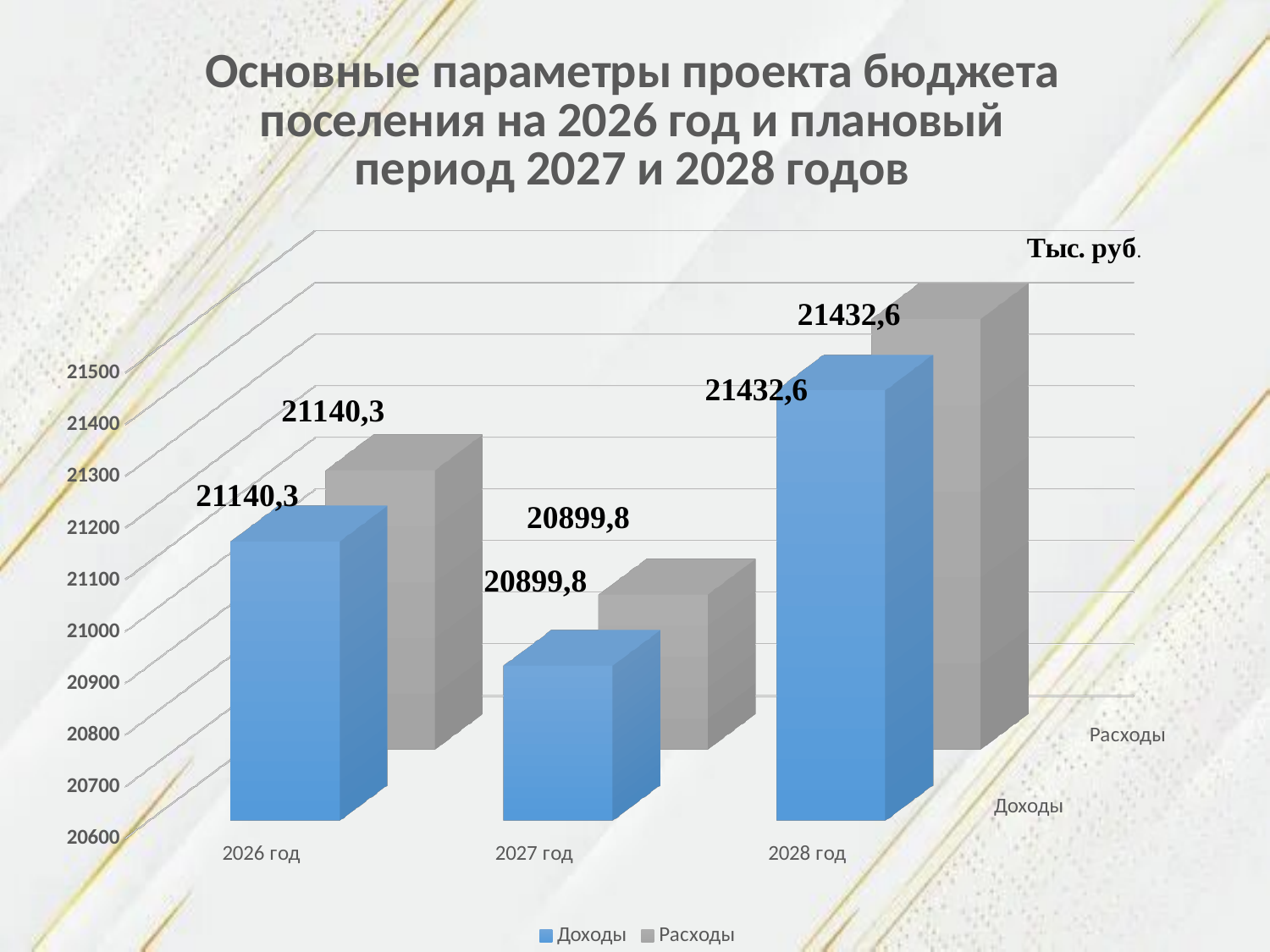
What kind of chart is shown on the slide? bar chart How many series does the legend list? 2 What is the value of Доходы for 2026 год? 21140,3 What is the value of Расходы for 2027 год? 20899,8 How many years are shown on the x axis? 3 What is the value of Доходы for 2028 год? 21432,6 Is the value of Доходы for 2027 год greater or less than 21000? less Which year has the highest value of Расходы? 2028 год Which year has the lowest value of Доходы? 2027 год Which is larger: Доходы in 2026 год or Доходы in 2027 год? Доходы in 2026 год What is the difference between Расходы in 2026 год and Расходы in 2027 год? 240,5 What is the difference between Доходы in 2028 год and Доходы in 2026 год? 292,3